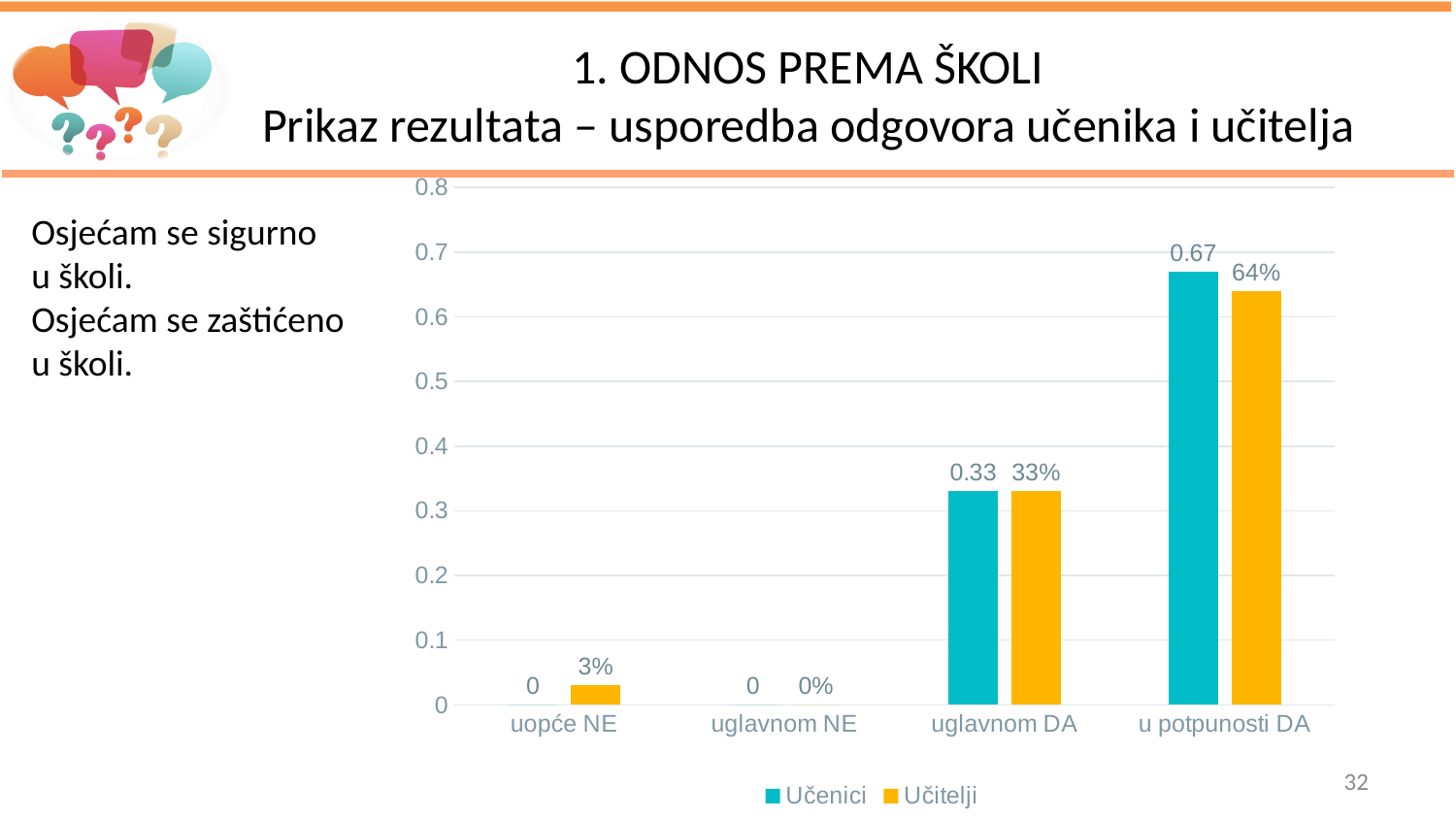
Which is larger in the category 'uopće NE': the value for Učenici or for Učitelji? Učitelji What is the value for Učitelji in the category 'u potpunosti DA'? 64% Which category has the lowest value for Učitelji? uglavnom NE What type of chart is shown on the slide? bar chart What is the value for Učenici in the category 'u potpunosti DA'? 0.67 Which series is shown in orange in the legend? Učitelji How many categories are shown on the x axis? 4 Is the value for Učenici in 'u potpunosti DA' greater or less than 0.6? greater Which category has the highest value for Učenici? u potpunosti DA How many series does the legend list? 2 What is the value for Učenici in the category 'uglavnom DA'? 0.33 What is the value for Učitelji in the category 'uopće NE'? 3%